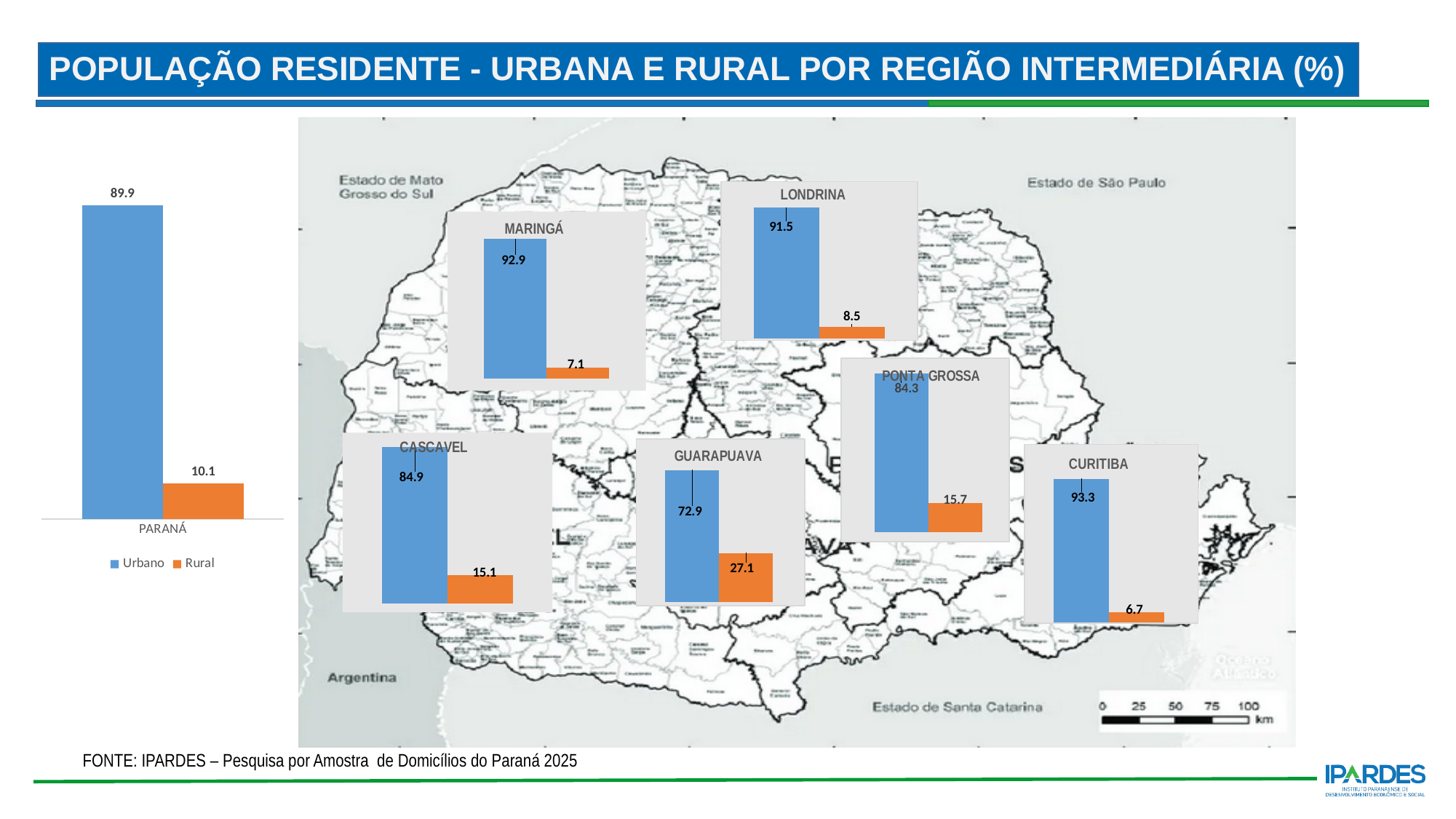
In the LONDRINA chart, what is the value of the Urbano bar? 91.5 In the GUARAPUAVA chart, what is the value of the Rural bar? 27.1 In the MARINGÁ chart, what is the value of the Rural bar? 7.1 How many series does the legend of the PARANÁ chart list? 2 Which colour represents Rural in the PARANÁ chart legend? Orange What kind of chart is the PARANÁ chart? Bar chart In the PARANÁ chart, what is the value for Urbano? 89.9 In the GUARAPUAVA chart, is the Urbano value greater or less than the Urbano value in the CURITIBA chart? less In the CASCAVEL chart, what is the total of the Urbano and Rural values? 100 In the PONTA GROSSA chart, which bar is larger, Urbano or Rural? Urbano In the PARANÁ chart, what is the value for Rural? 10.1 In the CURITIBA chart, what is the difference between the Urbano and Rural values? 86.6